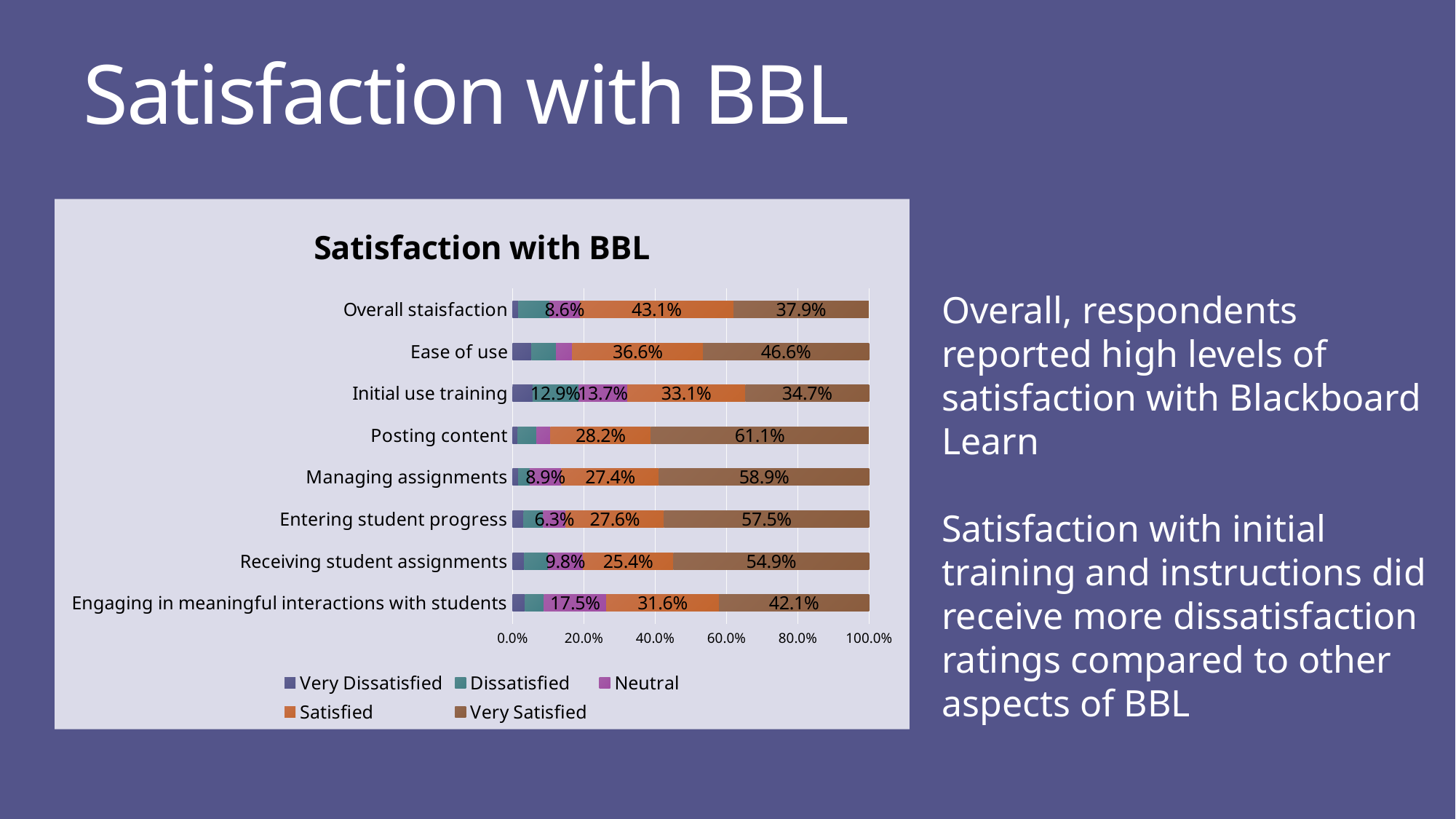
What is the Very Satisfied value for Initial use training? 34.7% What is the Neutral value for Engaging in meaningful interactions with students? 17.5% Which category has the highest Very Satisfied value? Posting content What is the Satisfied value for Ease of use? 36.6% How many categories are plotted in the 'Satisfaction with BBL' chart? 8 What is the Very Satisfied value for Posting content? 61.1% For Managing assignments, which is larger: the Satisfied value or the Very Satisfied value? Very Satisfied Which category has the lowest Very Satisfied value? Initial use training How many series does the legend of the 'Satisfaction with BBL' chart list? 5 What type of chart is shown on the slide? Stacked bar chart Which category has the highest Satisfied value? Overall staisfaction What is the difference between the Very Satisfied and Satisfied values for Ease of use? 10.0%